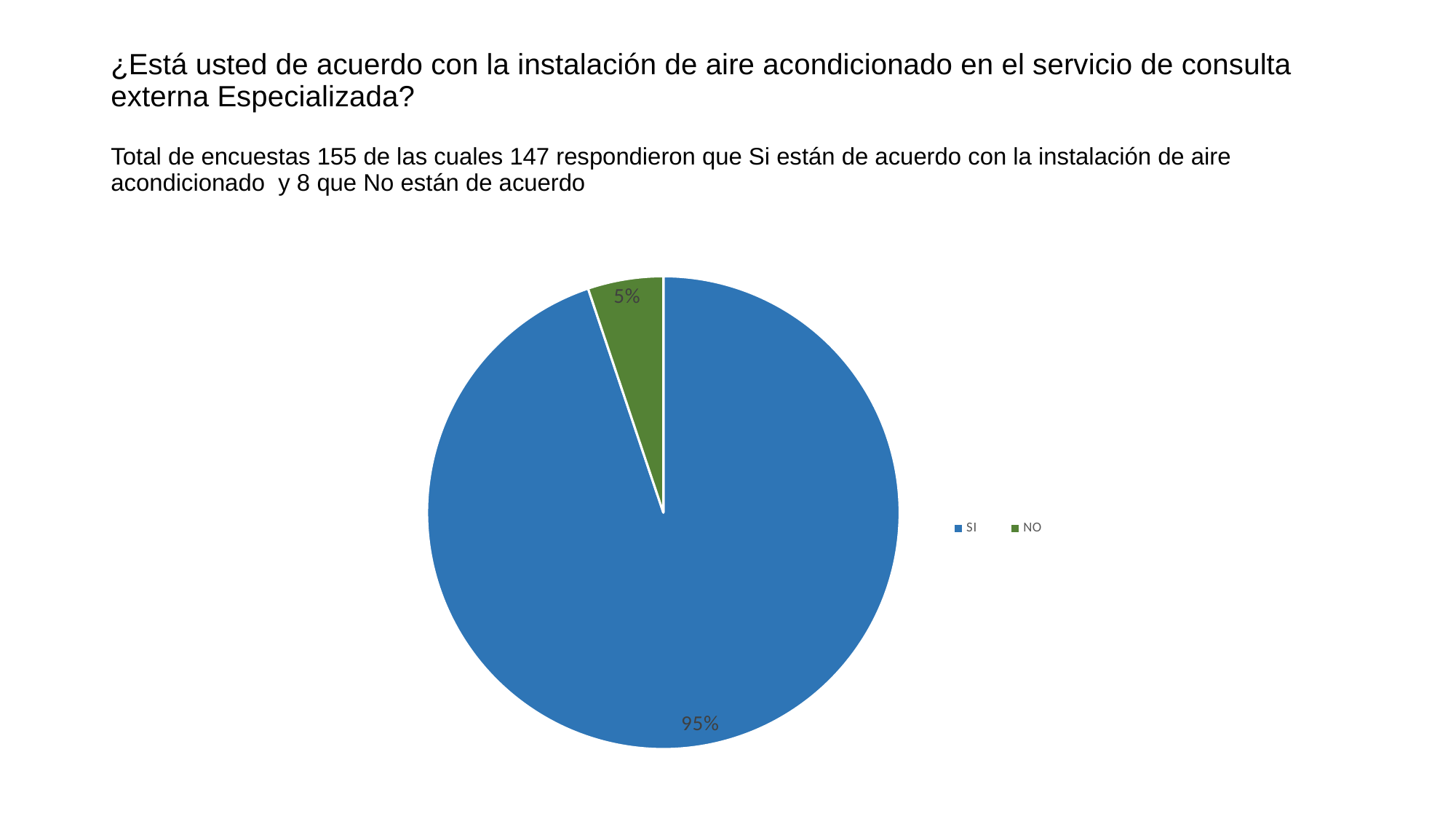
What share of the pie does the SI slice represent? 95% What share of the pie does the NO slice represent? 5% What colour is the NO slice? green What is the difference in percentage points between the SI slice and the NO slice? 90 What colour is the SI slice? blue Which is larger, the SI slice or the NO slice? SI What kind of chart is shown on the slide? pie chart How many entries does the legend list? 2 Which slice of the pie is the largest? SI Which slice of the pie is the smallest? NO How many slices does the pie chart have? 2